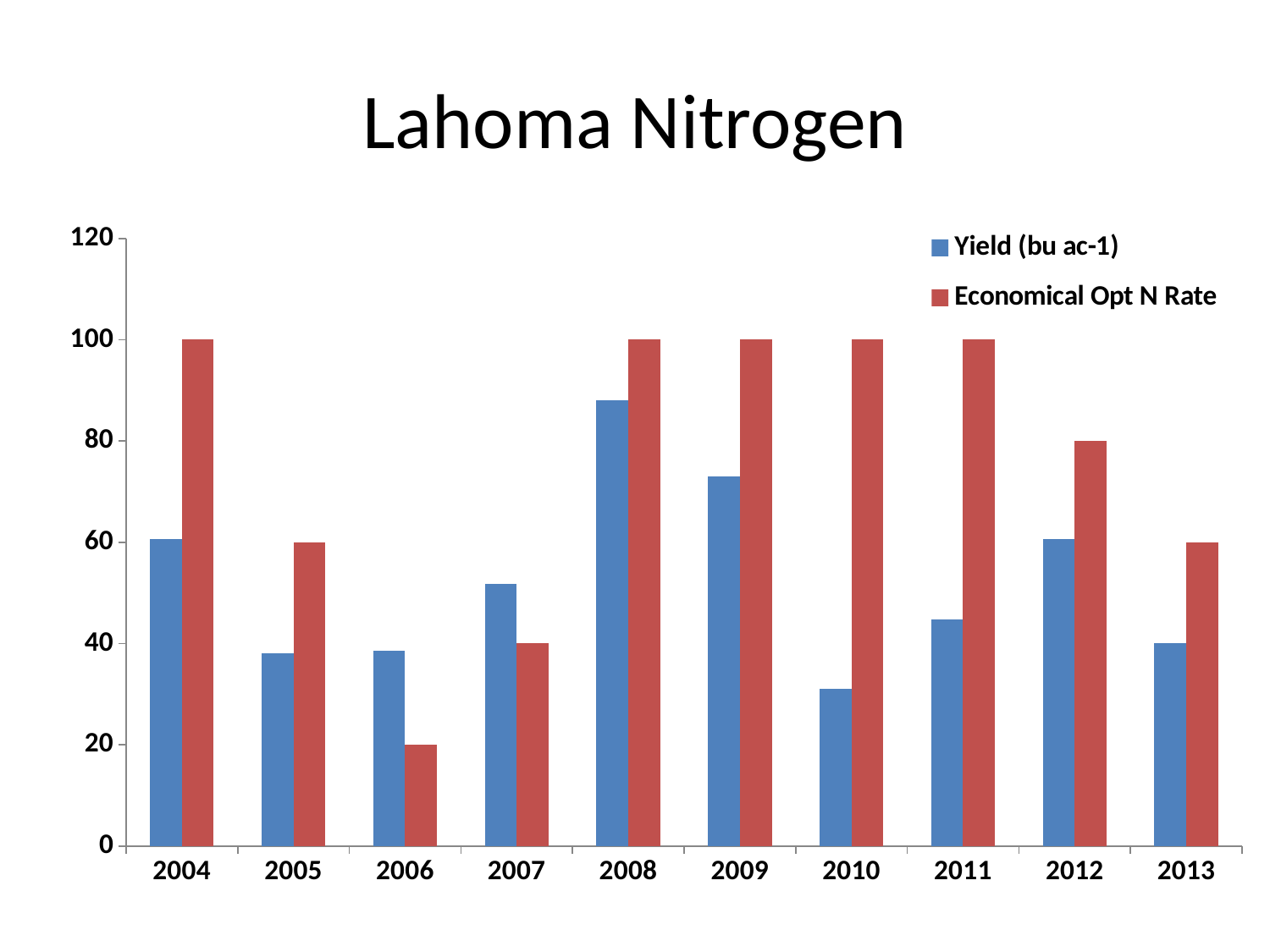
How many series does the legend list? 2 Which year has the highest Yield (bu ac-1)? 2008 What kind of chart is shown on the slide? bar chart Is the Yield (bu ac-1) for 2010 greater or less than 40? less In 2007, which is larger: Yield (bu ac-1) or Economical Opt N Rate? Yield (bu ac-1) How many years are shown on the x axis? 10 Which year has the lowest Yield (bu ac-1)? 2010 What is the Economical Opt N Rate for 2006? 20 Is the Yield (bu ac-1) for 2008 greater or less than 80? greater Which year has the lowest Economical Opt N Rate? 2006 What is the Economical Opt N Rate for 2012? 80 What is the Economical Opt N Rate for 2007? 40